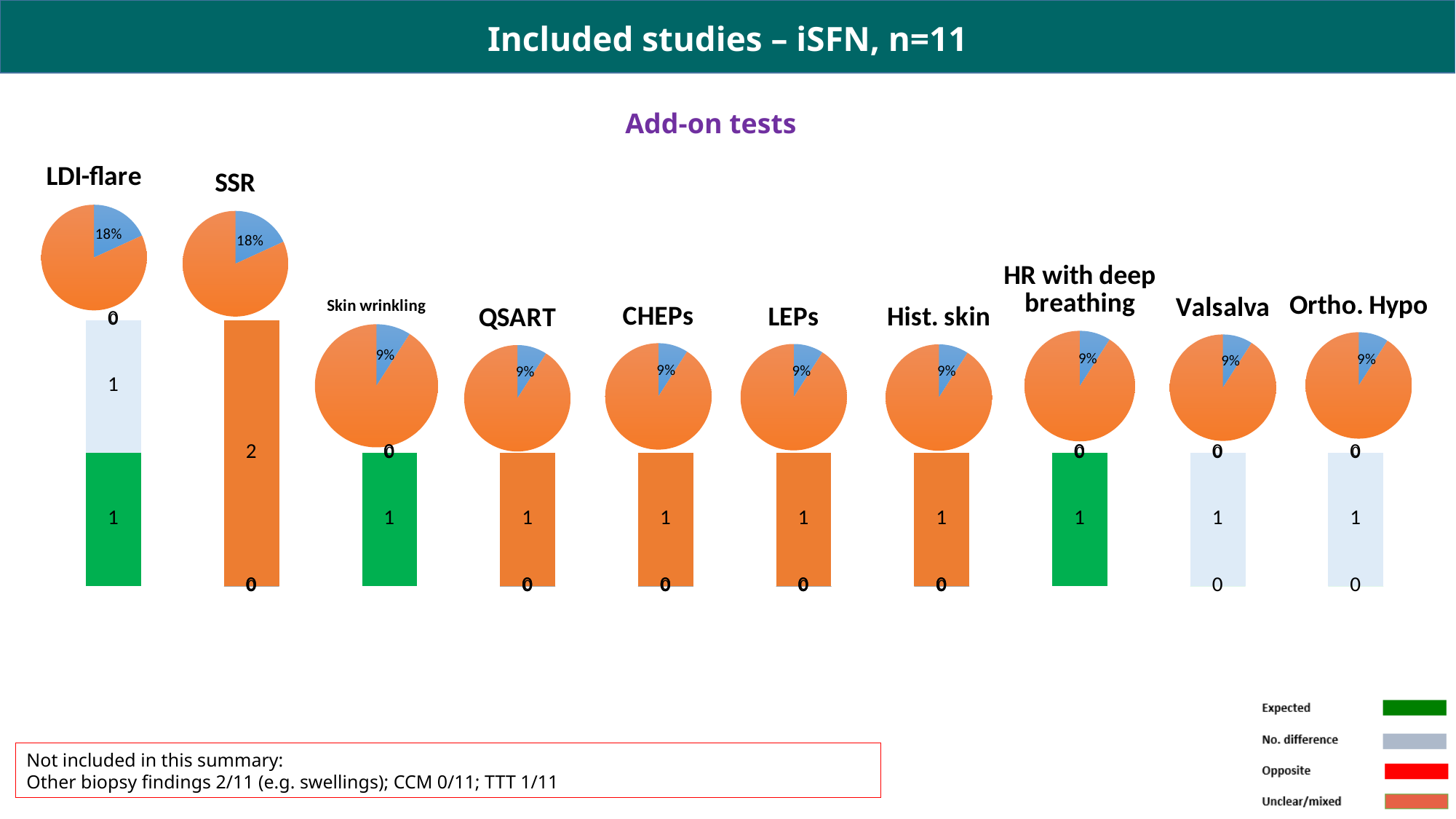
In the SSR bar, what value is printed on the orange segment? 2 What kind of chart is shown above each test label (e.g. above 'CHEPs')? Pie chart What value is printed on the Valsalva bar? 1 What is the total of the two segments in the LDI-flare stacked bar? 2 Which test has the tallest bar below its pie chart? SSR In the QSART pie chart, what percentage is shown for the blue slice? 9% According to the legend, which category does the orange colour of the SSR bar represent? Unclear/mixed What is the difference between the SSR bar value and the QSART bar value? 1 In the LDI-flare pie chart, what percentage is shown for the blue slice? 18% How many pie charts are shown on the slide? 10 Which pie chart has the larger blue slice, LDI-flare or Skin wrinkling? LDI-flare How many entries does the legend at the bottom right list? 4